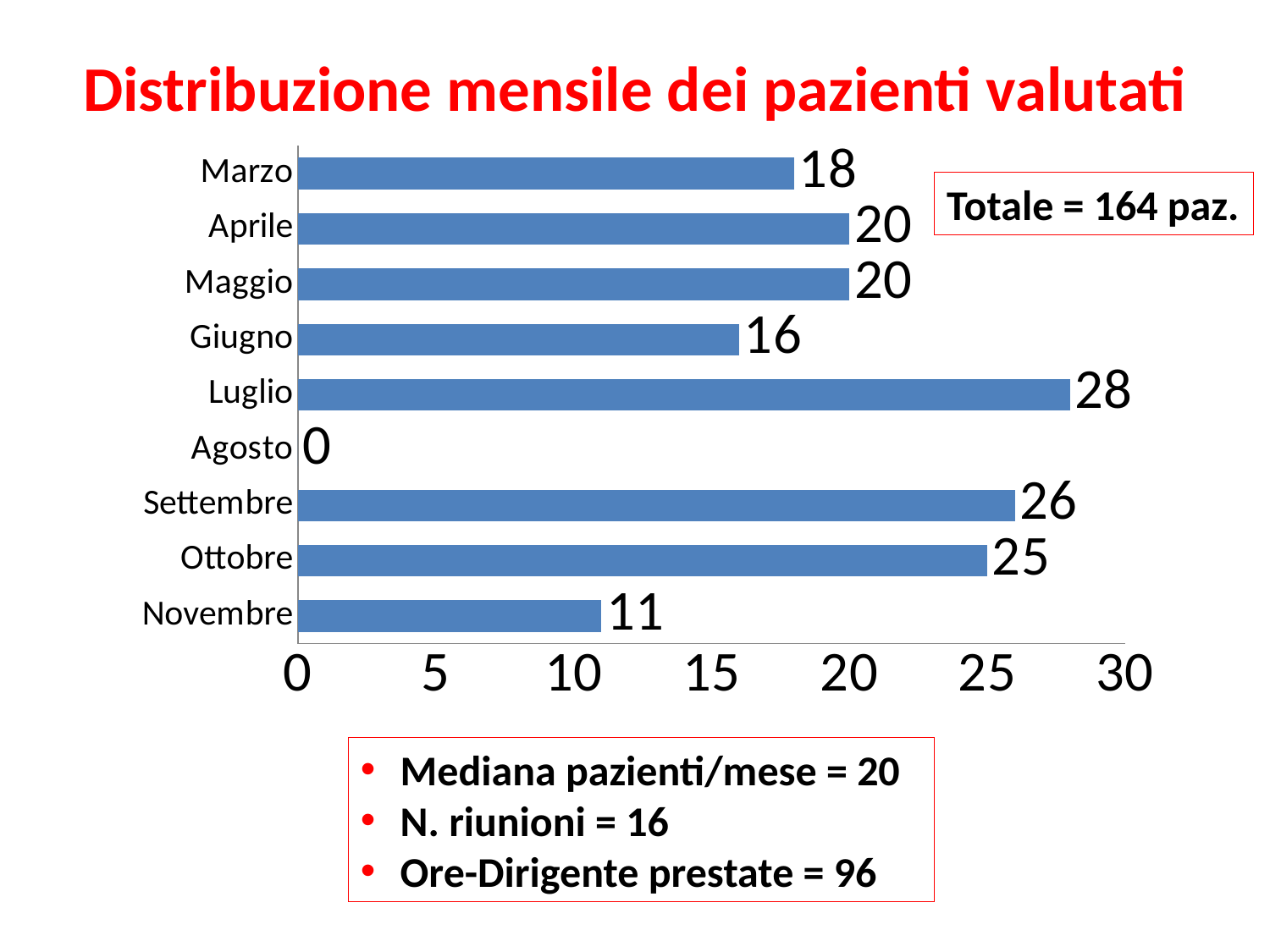
How many months are shown on the chart? 9 Which month has the highest value? Luglio What is the value for Novembre? 11 Which month has the lowest value? Agosto Is the value for Luglio greater or less than 25? greater What is the difference between the values for Settembre and Giugno? 10 What is the value for Luglio? 28 What kind of chart is shown on the slide? bar chart What total is stated in the box next to the chart? Totale = 164 paz. What is the title of the chart? Distribuzione mensile dei pazienti valutati Which is larger, the value for Ottobre or the value for Marzo? Ottobre What is the value for Agosto? 0